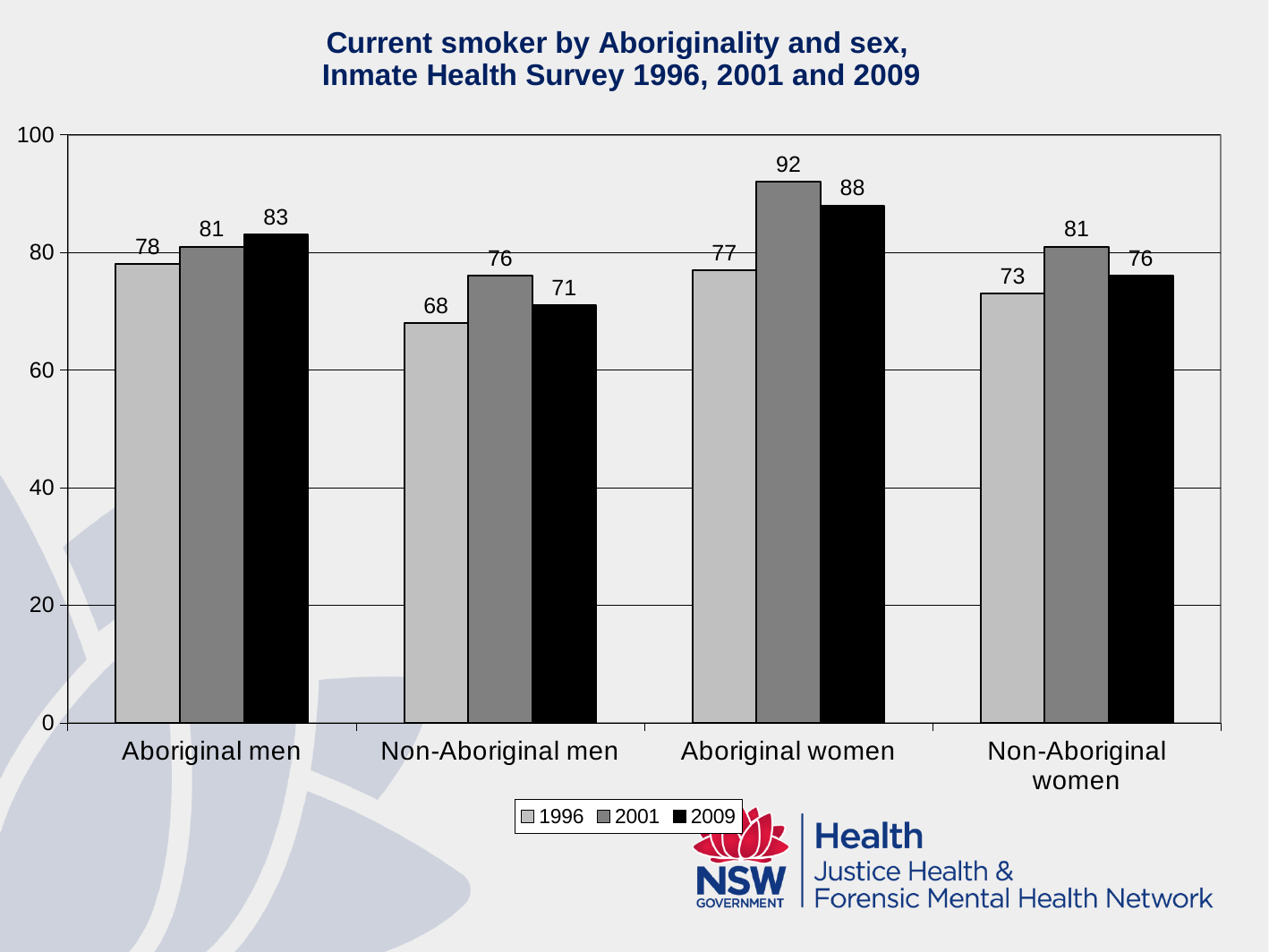
Do the values for Aboriginal men rise or fall from 1996 to 2009? Rise What is the value for Aboriginal women in 2001? 92 Which category has the lowest value in the 1996 series? Non-Aboriginal men What is the value for Non-Aboriginal women in 2009? 76 What is the value for Non-Aboriginal men in 1996? 68 How many series does the legend list? 3 What is the difference between the 2001 and 2009 values for Aboriginal women? 4 Which category has the highest value in the 2001 series? Aboriginal women What kind of chart is shown on the slide? Bar chart Which is larger for Non-Aboriginal men: the 2001 value or the 2009 value? 2001 What is the value for Aboriginal men in 2009? 83 How many categories are shown on the x axis? 4